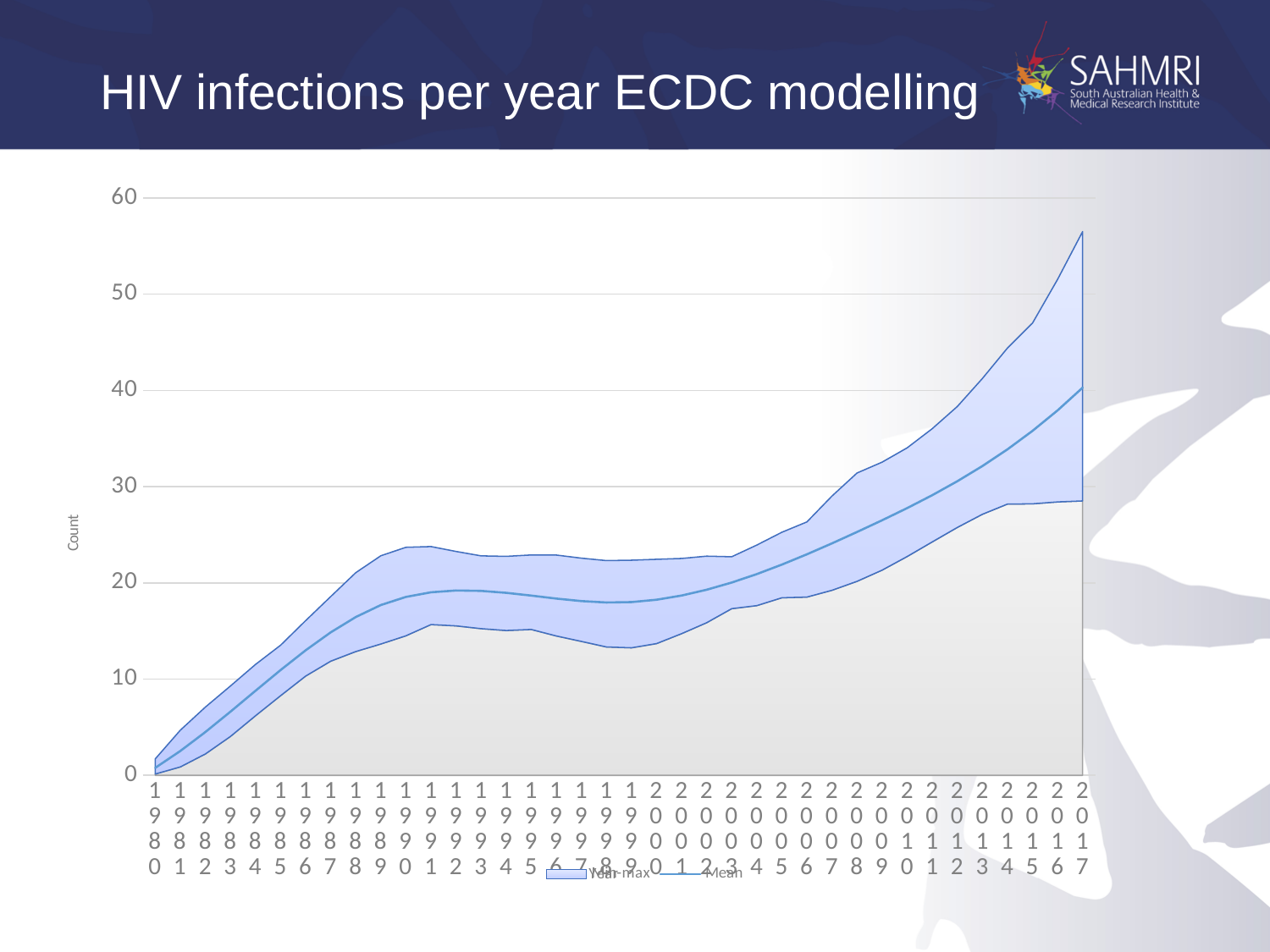
How many series does the legend list? 2 How many years are plotted along the x axis? 38 What kind of chart is shown on the slide? combination area and line chart Does the Mean line generally rise or fall from 1980 to 2017? rise Is the Mean value for 2010 greater or less than 20? greater In which year is the Mean value highest? 2017 What label is shown on the vertical axis? Count What is the title of the chart? HIV infections per year ECDC modelling Is the Mean value for 1980 greater or less than 10? less Is the Mean value for 2000 greater or less than 20? less In which year is the Mean value lowest? 1980